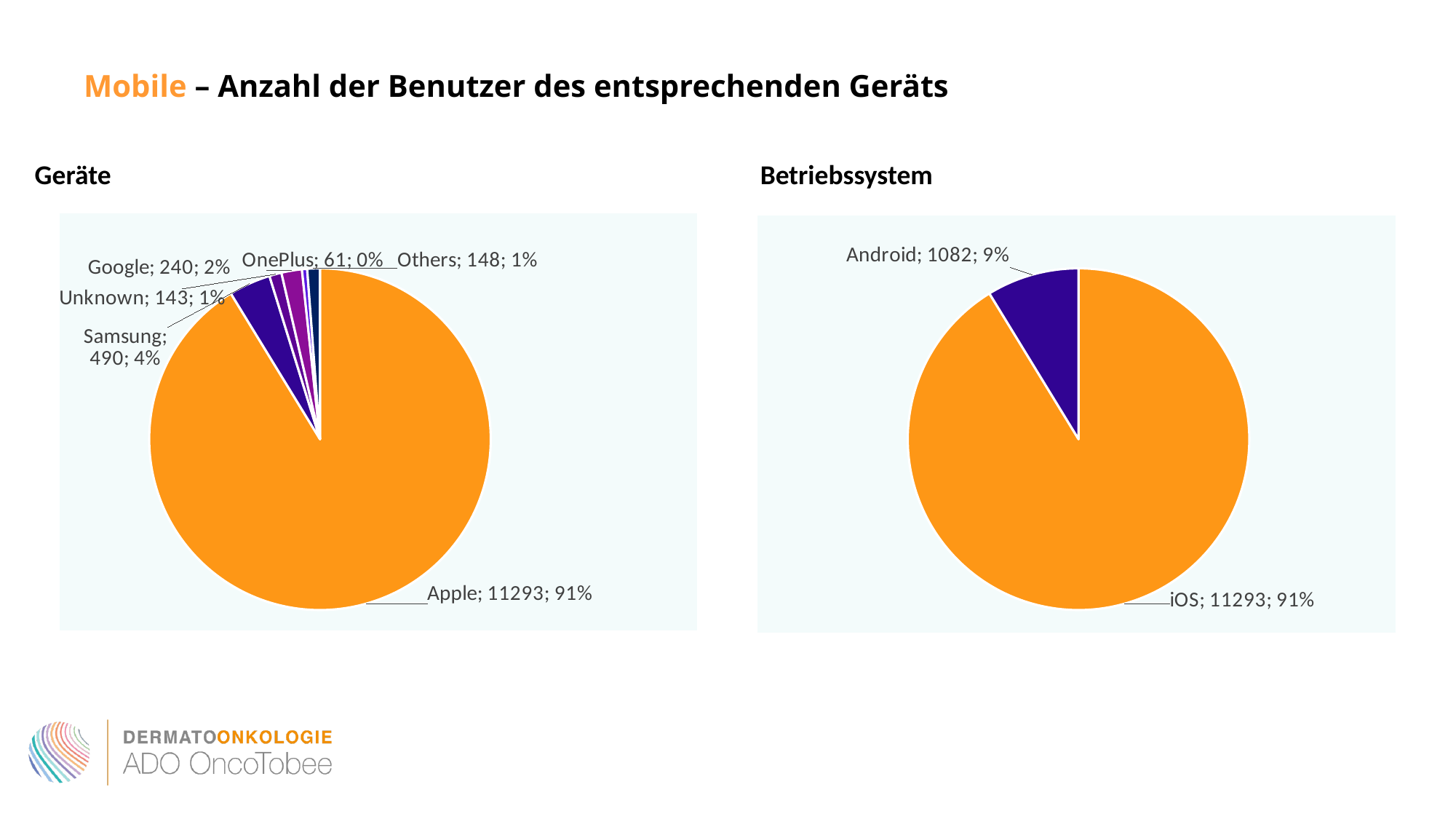
What kind of chart is the Betriebssystem chart? Pie chart In the Betriebssystem chart, what is the difference in users between iOS and Android? 10211 In the Geräte chart, how many users does Apple have? 11293 In the Geräte chart, which device has the fewest users? OnePlus In the Betriebssystem chart, how many users does Android have? 1082 In the Betriebssystem chart, what share of the pie does iOS have? 91% In the Geräte chart, what share of the pie does Google have? 2% In the Geräte chart, what is the difference in users between Samsung and Google? 250 In the Geräte chart, which has more users, Others or Unknown? Others In the Geräte chart, which device has the most users? Apple In the Geräte chart, how many slices does the pie have? 6 In the Geräte chart, how many users does Samsung have? 490